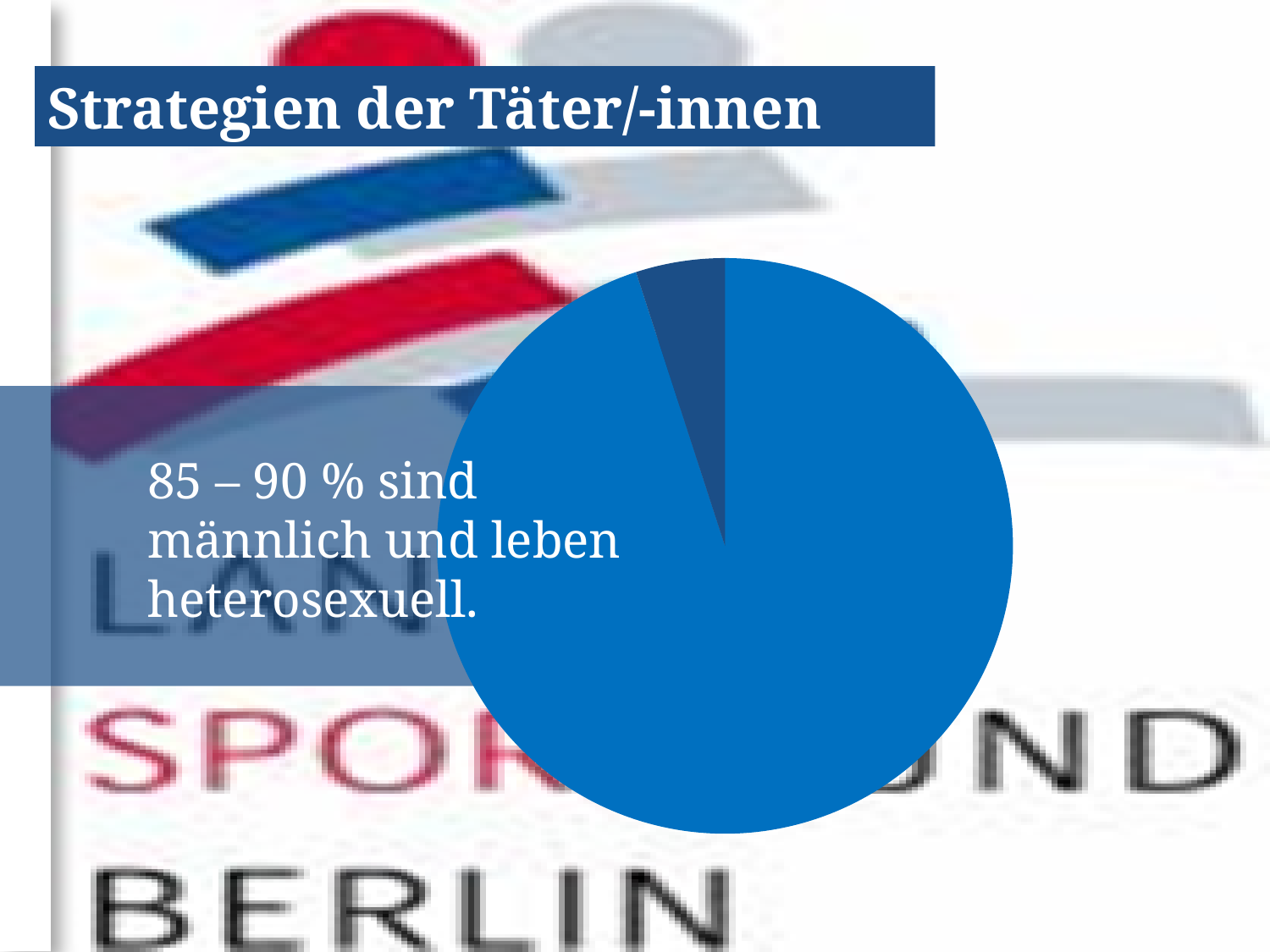
Which slice of the pie chart is the smallest? the dark blue slice Does the pie chart display a legend? No Which slice of the pie chart is larger, the light blue one or the dark blue one? the light blue one Does the pie chart show data labels with values on its slices? No What kind of chart is shown on the slide? pie chart How many slices does the pie chart have? 2